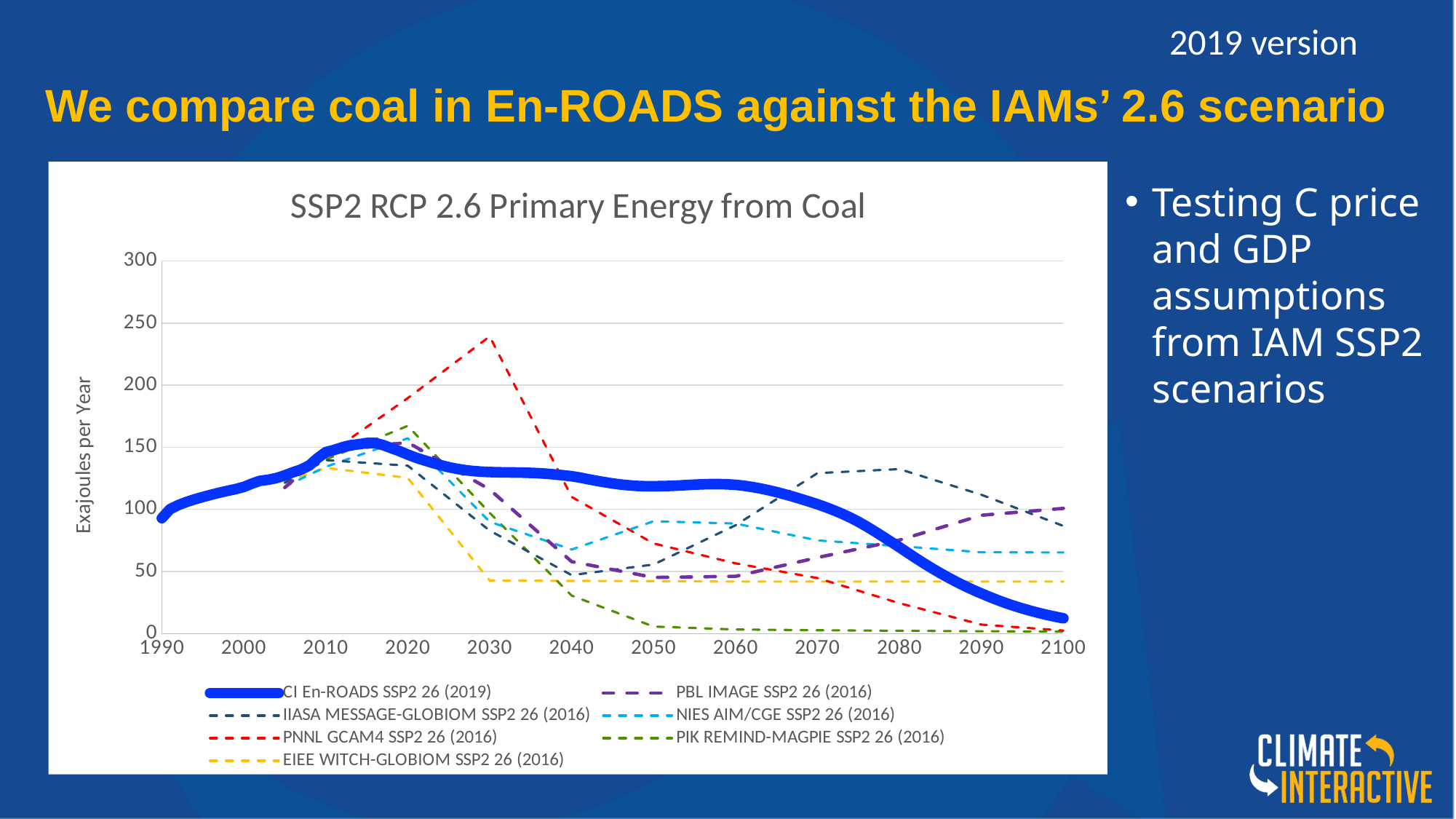
How many series does the chart legend list? 7 Does the CI En-ROADS SSP2 26 (2019) line rise or fall between 2060 and 2100? fall In 2080, which series has the higher value: IIASA MESSAGE-GLOBIOM SSP2 26 (2016) or CI En-ROADS SSP2 26 (2019)? IIASA MESSAGE-GLOBIOM SSP2 26 (2016) Is the value for CI En-ROADS SSP2 26 (2019) in 2100 greater or less than 50? less How many year labels are shown on the horizontal axis? 12 What is the label on the vertical axis of the chart? Exajoules per Year Is the value for PIK REMIND-MAGPIE SSP2 26 (2016) in 2060 greater or less than 50? less Is the value for PNNL GCAM4 SSP2 26 (2016) in 2030 greater or less than 200? greater Which series reaches the highest value anywhere on the chart? PNNL GCAM4 SSP2 26 (2016) What kind of chart is shown on the slide? line chart In 2030, which series has the higher value: PNNL GCAM4 SSP2 26 (2016) or CI En-ROADS SSP2 26 (2019)? PNNL GCAM4 SSP2 26 (2016) What is the title of the chart? SSP2 RCP 2.6 Primary Energy from Coal